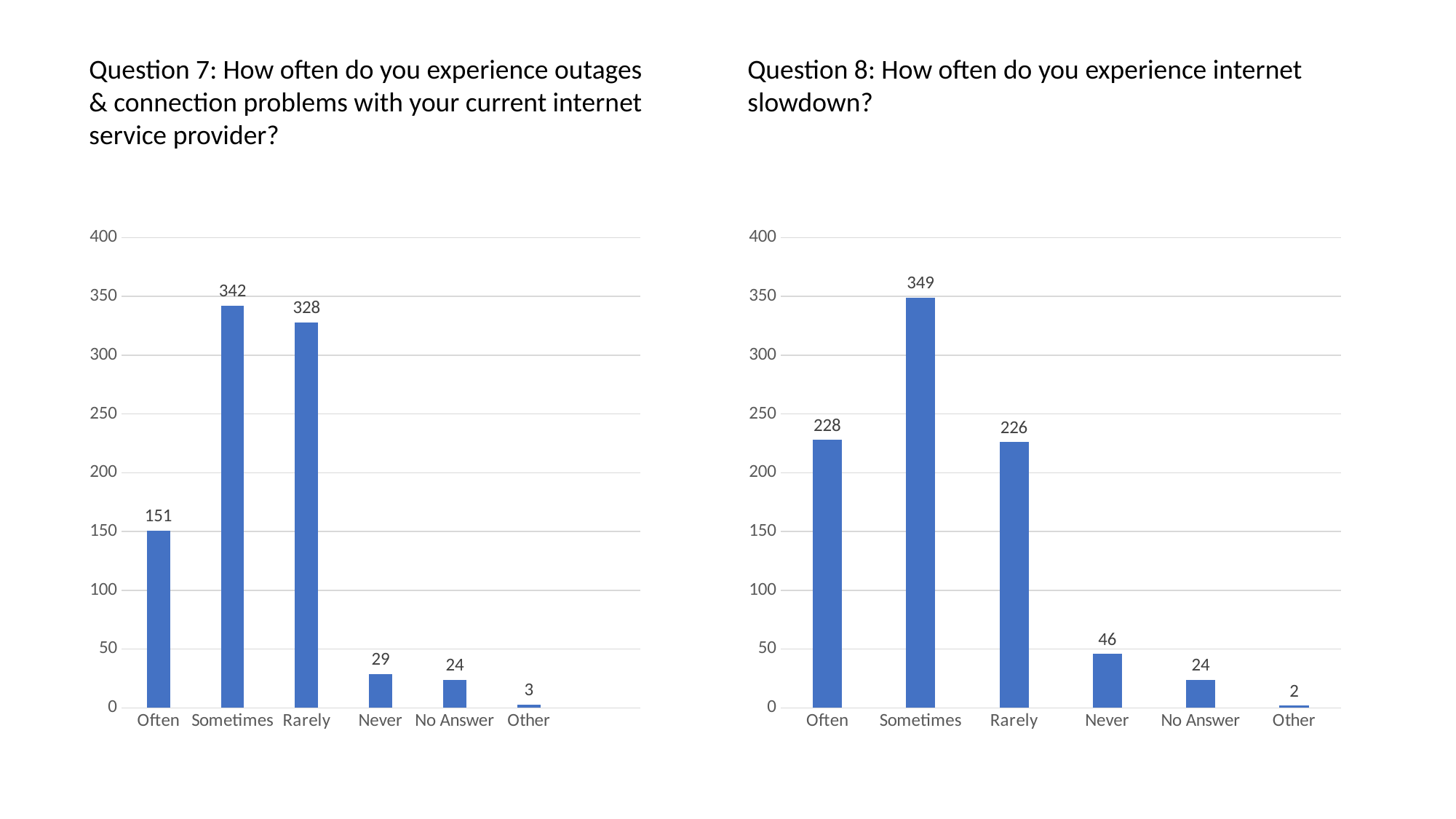
In the Question 7 chart (left), what is the value for Sometimes? 342 How many categories are shown on the x axis of the Question 8 chart (right)? 6 In the Question 7 chart (left), what is the value for No Answer? 24 In the Question 8 chart (right), which category has the lowest value? Other In the Question 8 chart (right), what is the value for Often? 228 In the Question 7 chart (left), what is the difference between the values for Sometimes and Rarely? 14 What is the title of the chart on the right? Question 8: How often do you experience internet slowdown? In the Question 7 chart (left), which category has the highest value? Sometimes In the Question 8 chart (right), what is the difference between the values for Sometimes and Never? 303 What kind of chart is the Question 7 chart (left)? Bar chart In the Question 8 chart (right), which is larger, the value for Often or the value for Never? Often In the Question 7 chart (left), is the value for Rarely greater or less than 300? greater